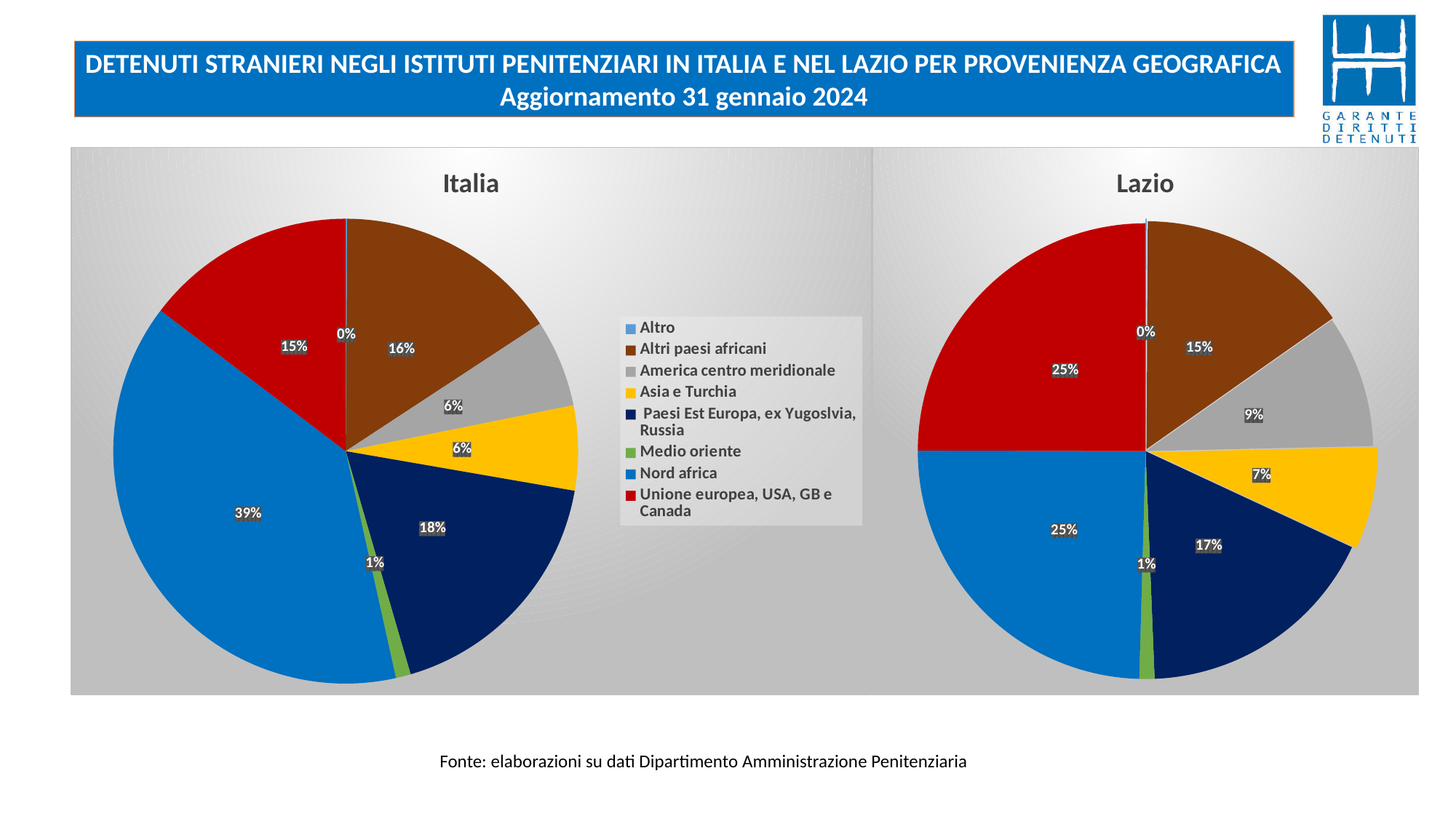
How many series does the legend list? 8 What type of chart is used for the Italia data? pie chart In the Lazio chart, what is the share for America centro meridionale? 9% What is the difference between the Nord africa share in the Italia chart and in the Lazio chart? 14 percentage points In the Italia chart, which category has the largest share? Nord africa In the Lazio chart, which category has the smallest share? Altro In the Italia chart, what is the share for Medio oriente? 1% In the Italia chart, what is the share for Paesi Est Europa, ex Yugoslvia, Russia? 18% In the Lazio chart, what is the share for Asia e Turchia? 7% What colour represents Nord africa in the legend? blue In the Italia chart, what share of the pie is Nord africa? 39% Which is larger: the Unione europea, USA, GB e Canada share in the Italia chart or in the Lazio chart? Lazio